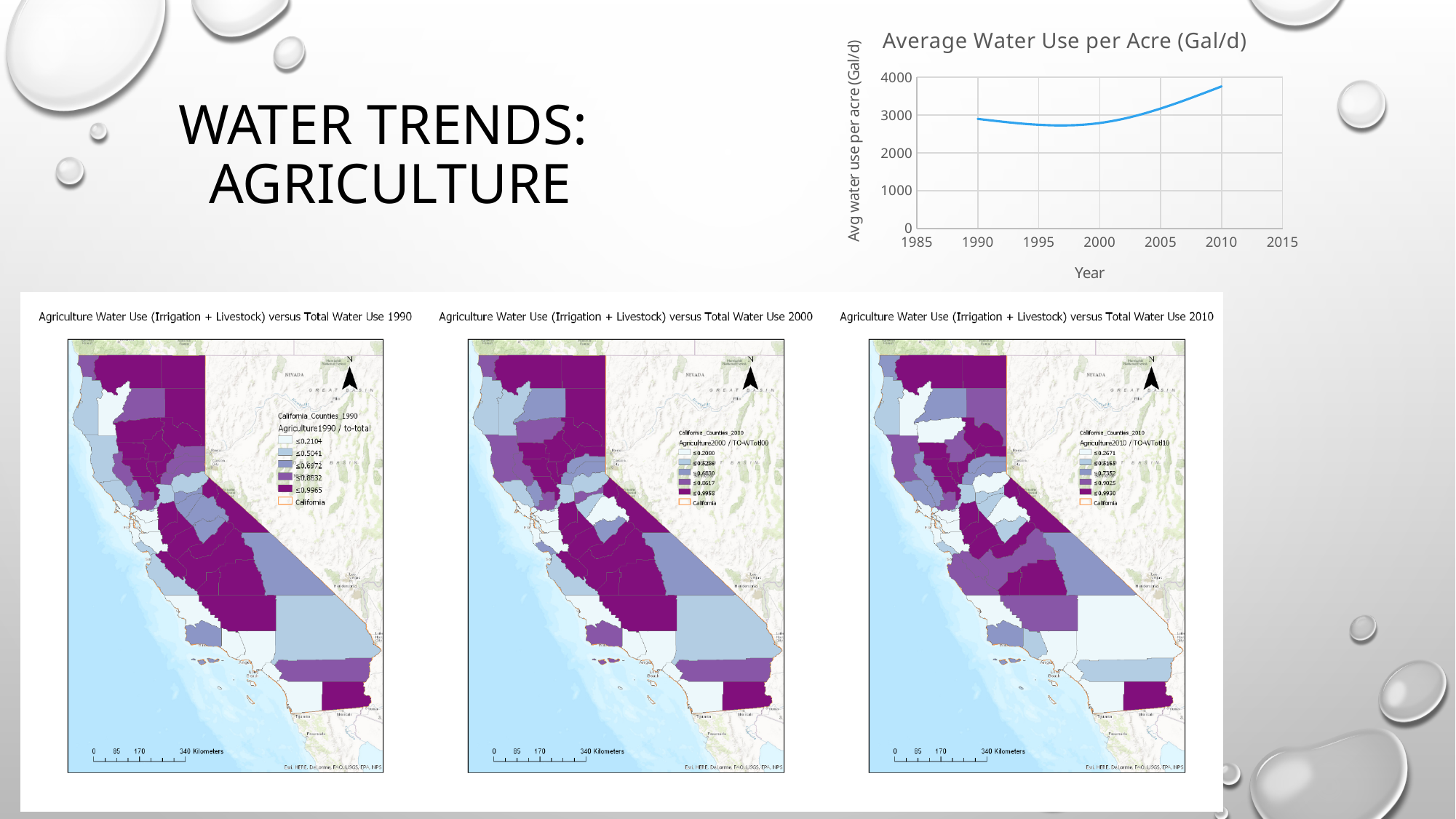
In the 'Average Water Use per Acre (Gal/d)' chart, which year has the higher value, 1990 or 2010? 2010 In the 'Average Water Use per Acre (Gal/d)' chart, is the value for 2000 greater or less than 3000? less In the 'Average Water Use per Acre (Gal/d)' chart, is the value for 2010 greater or less than 3000? greater What is the y-axis label of the 'Average Water Use per Acre (Gal/d)' chart? Avg water use per acre (Gal/d) In the 'Average Water Use per Acre (Gal/d)' chart, does the line rise or fall between 1990 and 1995? fall In the 'Average Water Use per Acre (Gal/d)' chart, is the value for 1990 greater or less than 2000? greater In the 'Average Water Use per Acre (Gal/d)' chart, does the line rise or fall between 2000 and 2010? rise What kind of chart is the 'Average Water Use per Acre (Gal/d)' chart? line chart In the 'Average Water Use per Acre (Gal/d)' chart, which plotted year has the highest value? 2010 What is the x-axis label of the 'Average Water Use per Acre (Gal/d)' chart? Year